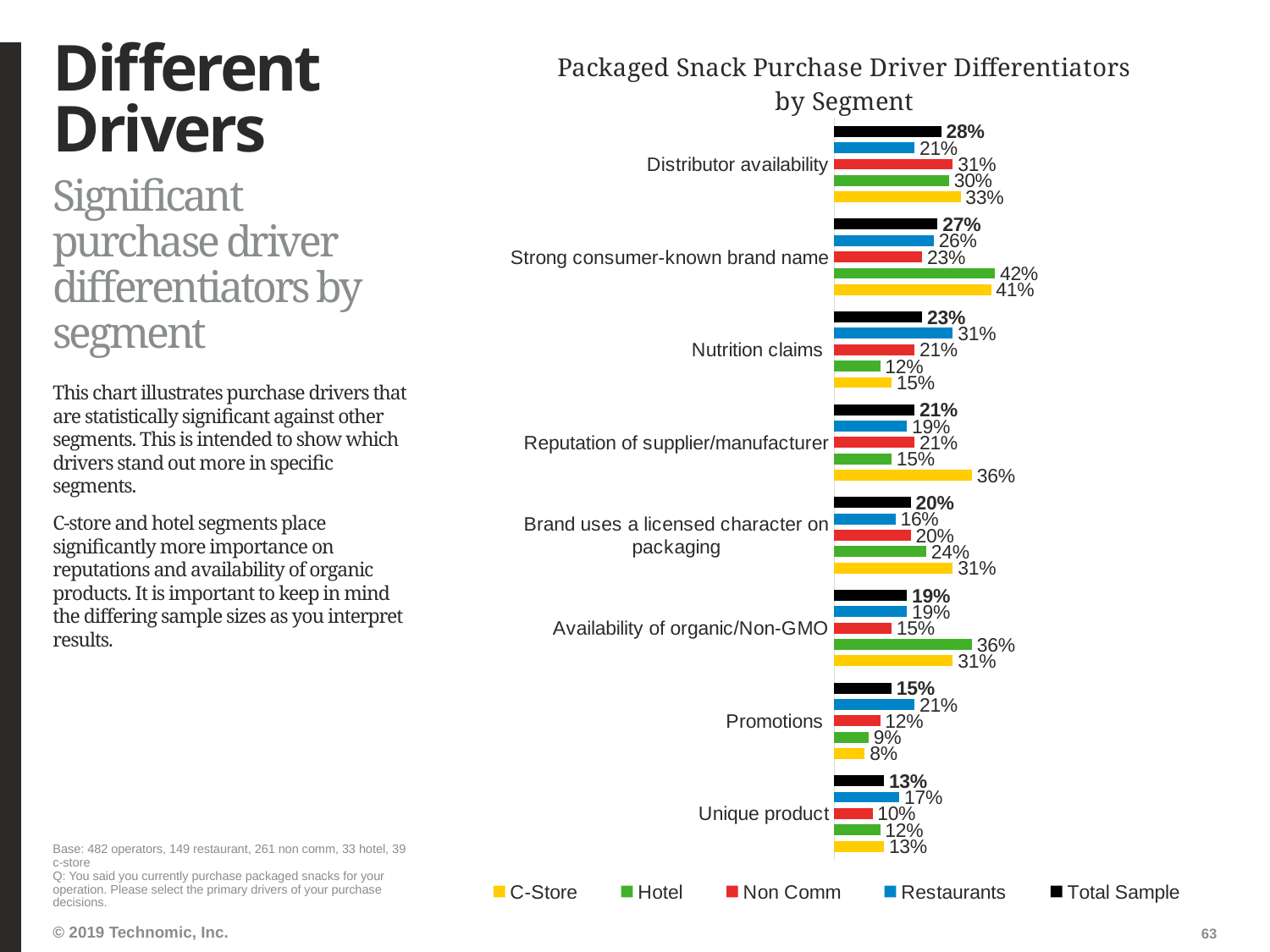
What kind of chart is shown on the slide? Bar chart What is the difference between the Hotel and Non Comm values for Availability of organic/Non-GMO? 21% For Promotions, which is larger: the Restaurants value or the Non Comm value? Restaurants What is the Total Sample value for Distributor availability? 28% Which category has the lowest C-Store value? Promotions What is the Restaurants value for Nutrition claims? 31% What is the Hotel value for Strong consumer-known brand name? 42% How many categories are shown on the chart? 8 Which colour represents the Hotel series in the chart? Green Which category has the highest Total Sample value? Distributor availability How many series does the legend list? 5 What is the C-Store value for Reputation of supplier/manufacturer? 36%